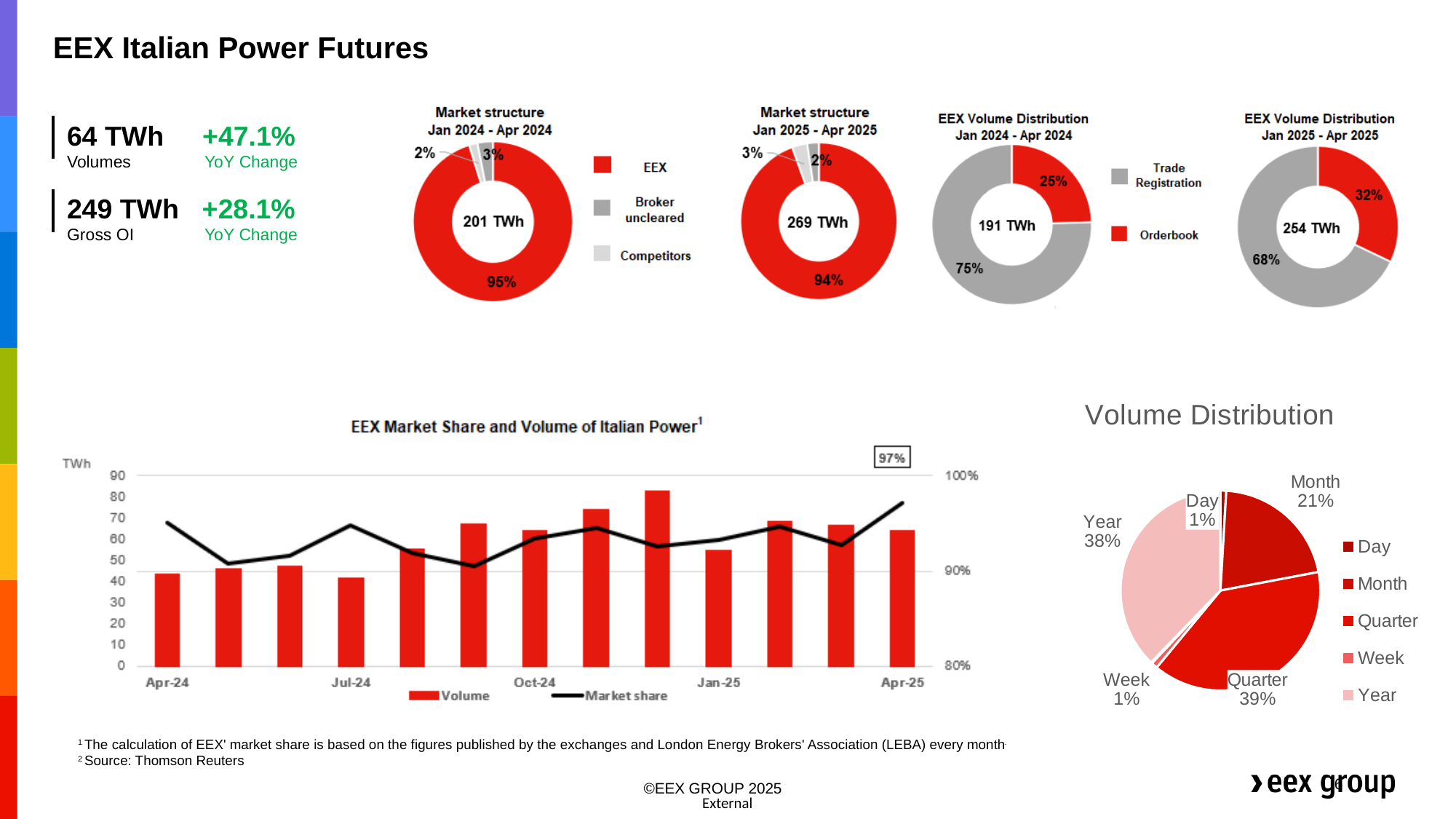
In the EEX Volume Distribution Jan 2024 - Apr 2024 donut chart, what is the difference between the Trade Registration share and the Orderbook share? 50 percentage points What total volume is shown in the centre of the Market structure Jan 2025 - Apr 2025 donut chart? 269 TWh In the Market structure Jan 2024 - Apr 2024 donut chart, what share does EEX have? 95% In the EEX Market Share and Volume of Italian Power chart, what market share value is labelled for Apr-25? 97% In the Volume Distribution pie chart, what share does Quarter have? 39% How many categories does the Volume Distribution pie chart show? 5 In the Volume Distribution pie chart, which category has the largest share? Quarter In the Volume Distribution pie chart, what is the difference between the Year share and the Month share? 17 percentage points In the EEX Volume Distribution Jan 2025 - Apr 2025 donut chart, what share does Orderbook have? 32% How many series does the legend of the EEX Market Share and Volume of Italian Power chart list? 2 In the EEX Market Share and Volume of Italian Power chart, is the volume bar for Jul-24 greater or less than 50 TWh? less How many legend entries does the Market structure Jan 2024 - Apr 2024 donut chart have? 3